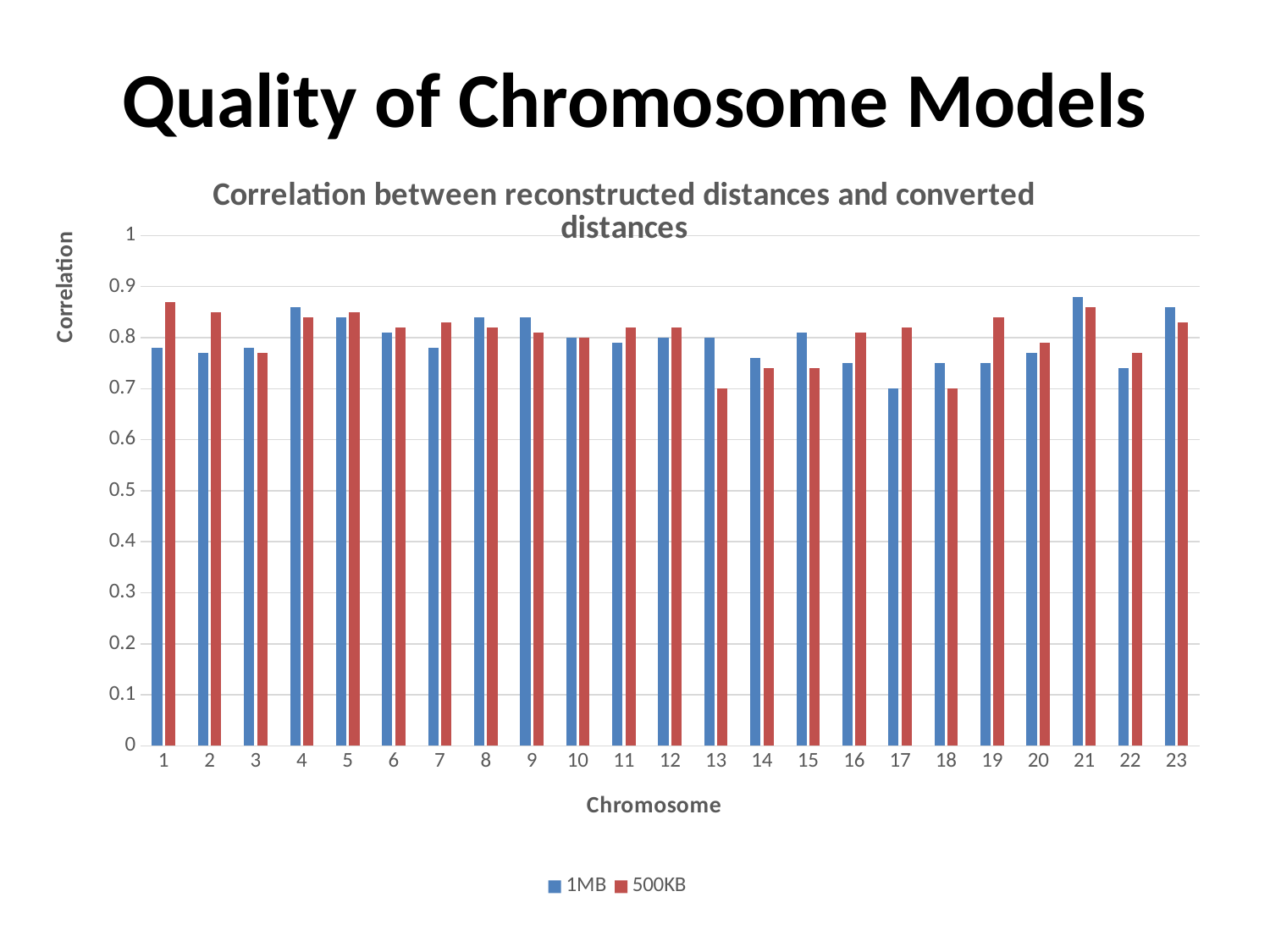
How many chromosomes are shown along the x axis of the chart? 23 Which series is drawn in red in the chart? 500KB For which chromosome is the 1MB correlation lowest? 17 Is the 1MB correlation for chromosome 22 greater or less than 0.8? less Is the 500KB correlation for chromosome 19 greater or less than 0.8? greater For chromosome 13, which series has the higher correlation, 1MB or 500KB? 1MB For chromosome 1, which series has the higher correlation, 1MB or 500KB? 500KB How many series does the chart's legend list? 2 What kind of chart is shown on the slide? bar chart Is the 1MB correlation for chromosome 14 greater or less than 0.8? less What is the title of the chart? Correlation between reconstructed distances and converted distances For which chromosome is the 1MB correlation highest? 21